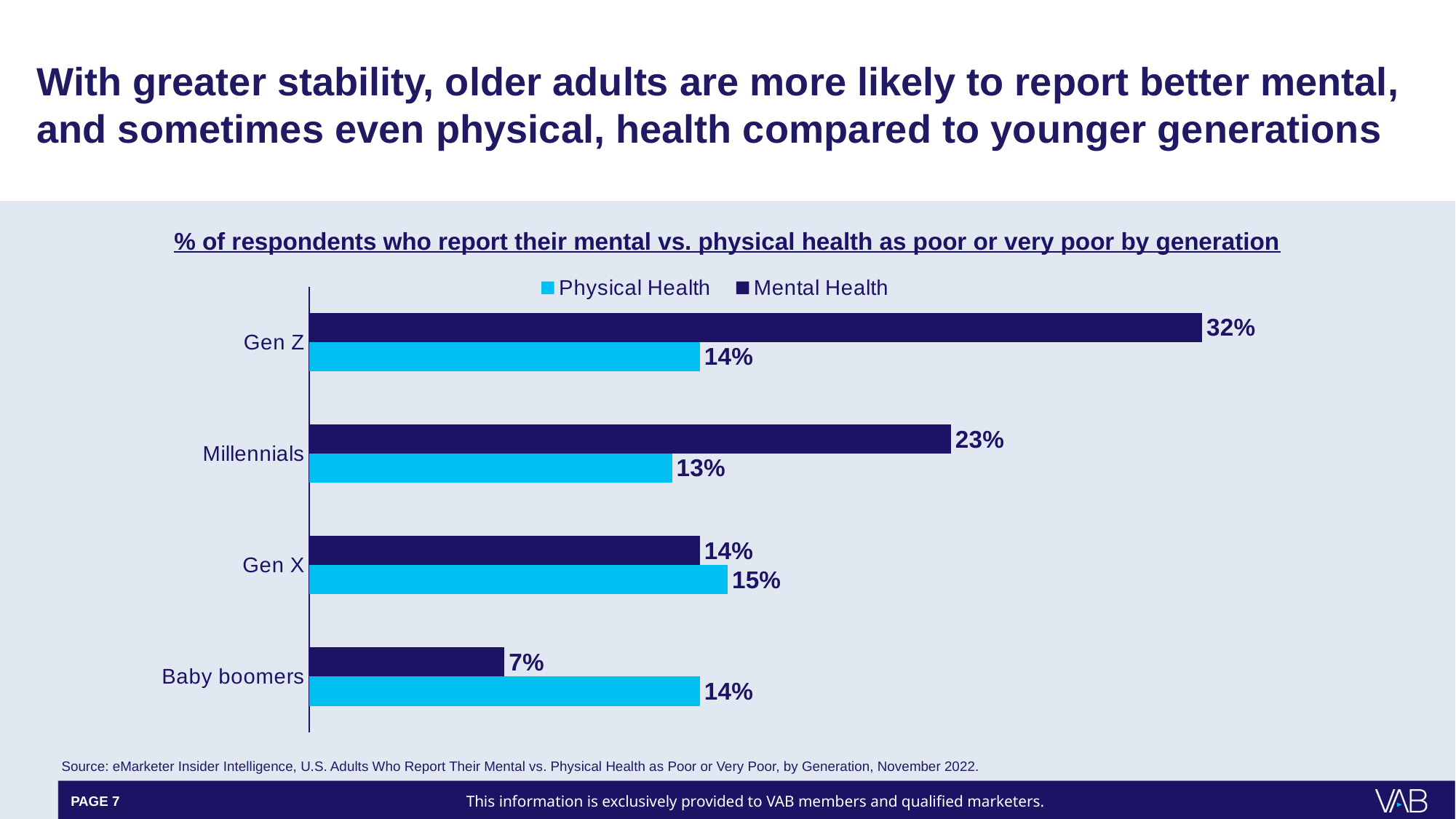
What kind of chart is shown on the slide? Bar chart How many series does the legend list? 2 What is the Mental Health value for Gen Z? 32% How many generations are shown on the chart? 4 What is the difference between the Mental Health and Physical Health values for Gen Z? 18% Which generation has the highest Mental Health value? Gen Z Which generation has the lowest Mental Health value? Baby boomers What is the Physical Health value for Millennials? 13% What is the Mental Health value for Baby boomers? 7% Which colour represents Physical Health in the chart? Light blue For Baby boomers, which is larger: the Physical Health value or the Mental Health value? Physical Health What is the difference between the Mental Health values for Millennials and Gen X? 9%